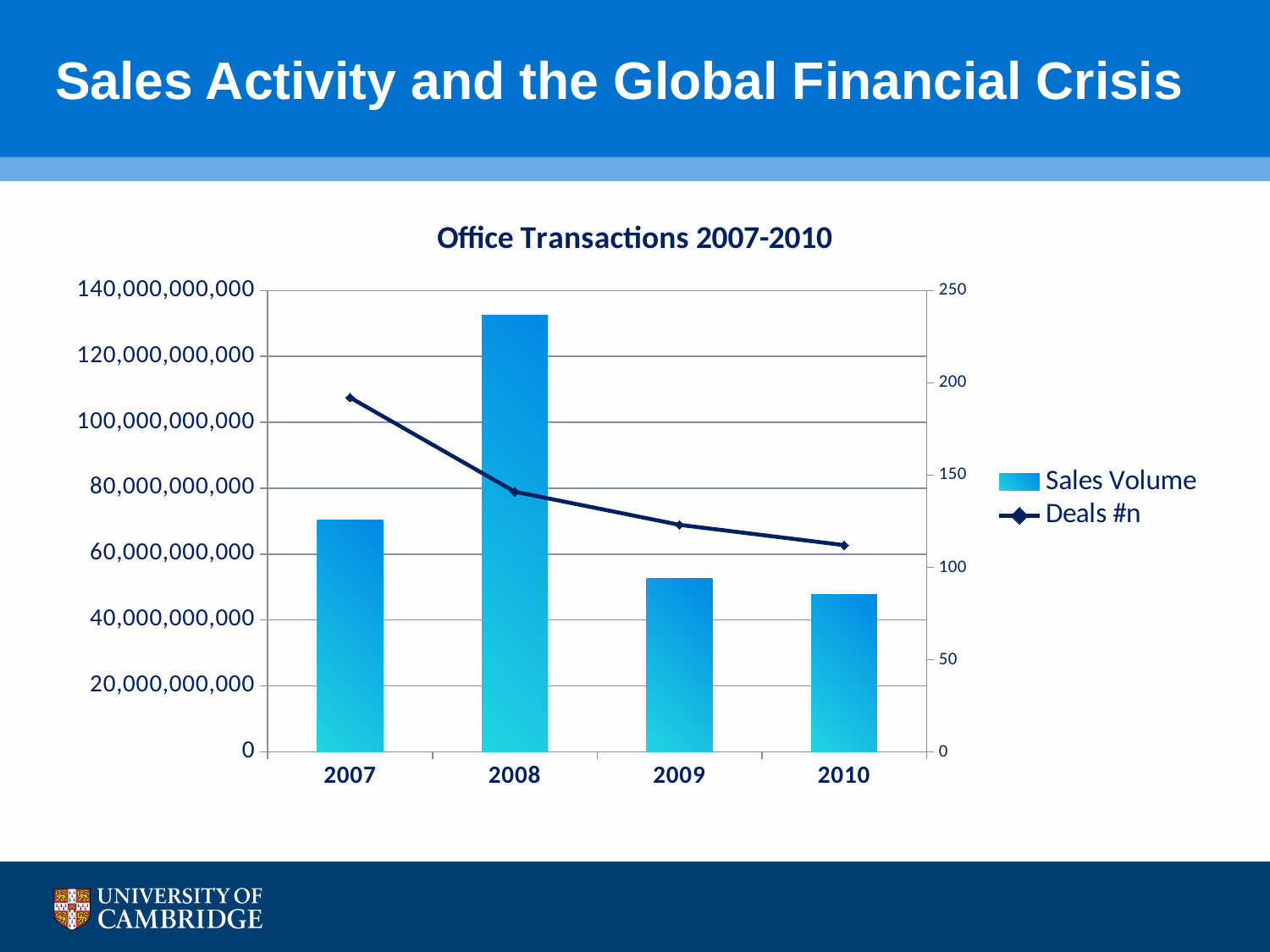
Which year has the highest Sales Volume? 2008 Which year has the lowest Sales Volume? 2010 What kind of chart is this? Combined bar and line chart Is the Sales Volume for 2010 greater or less than 60,000,000,000? less How many series does the legend list? 2 How many years are shown on the x axis? 4 Does the Deals #n line rise or fall from 2007 to 2010? fall Is the Deals #n value for 2007 greater or less than 150? greater Is the Deals #n value for 2009 greater or less than 150? less What are the two series named in the legend? Sales Volume and Deals #n What is the title of the chart? Office Transactions 2007-2010